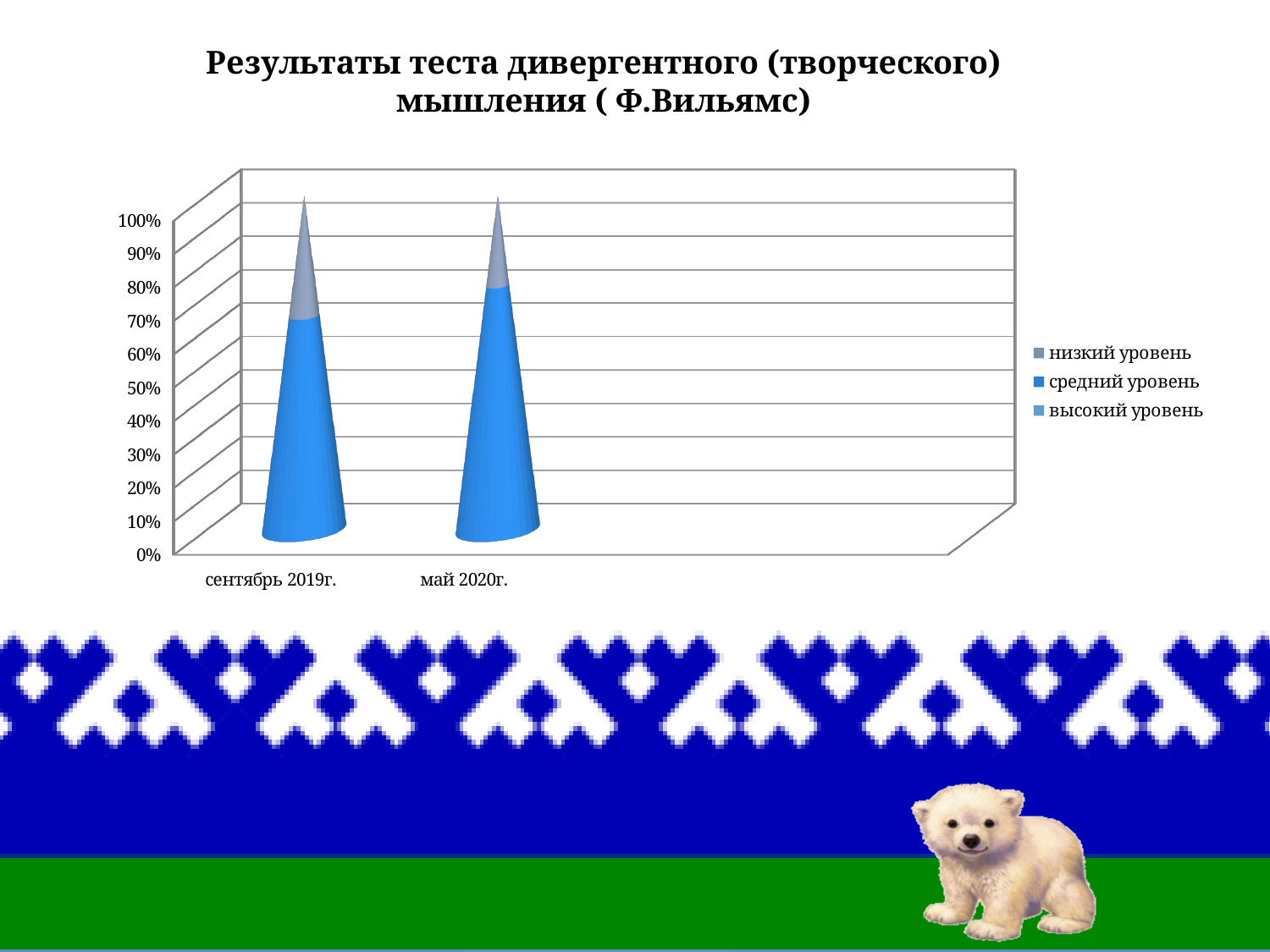
Is the value for средний уровень in сентябрь 2019г. greater or less than 50%? greater Which series is listed first in the chart legend? низкий уровень Does the value for низкий уровень rise or fall from сентябрь 2019г. to май 2020г.? fall Which category has the larger value for средний уровень, сентябрь 2019г. or май 2020г.? май 2020г. Is the value for средний уровень in май 2020г. greater or less than 60%? greater How many categories are shown on the x axis of the chart? 2 Is the value for низкий уровень in сентябрь 2019г. greater or less than 50%? less Which category has the larger value for низкий уровень, сентябрь 2019г. or май 2020г.? сентябрь 2019г. What kind of chart is shown on the slide? bar chart What are the two categories on the x axis of the chart? сентябрь 2019г. and май 2020г. How many series does the chart legend list? 3